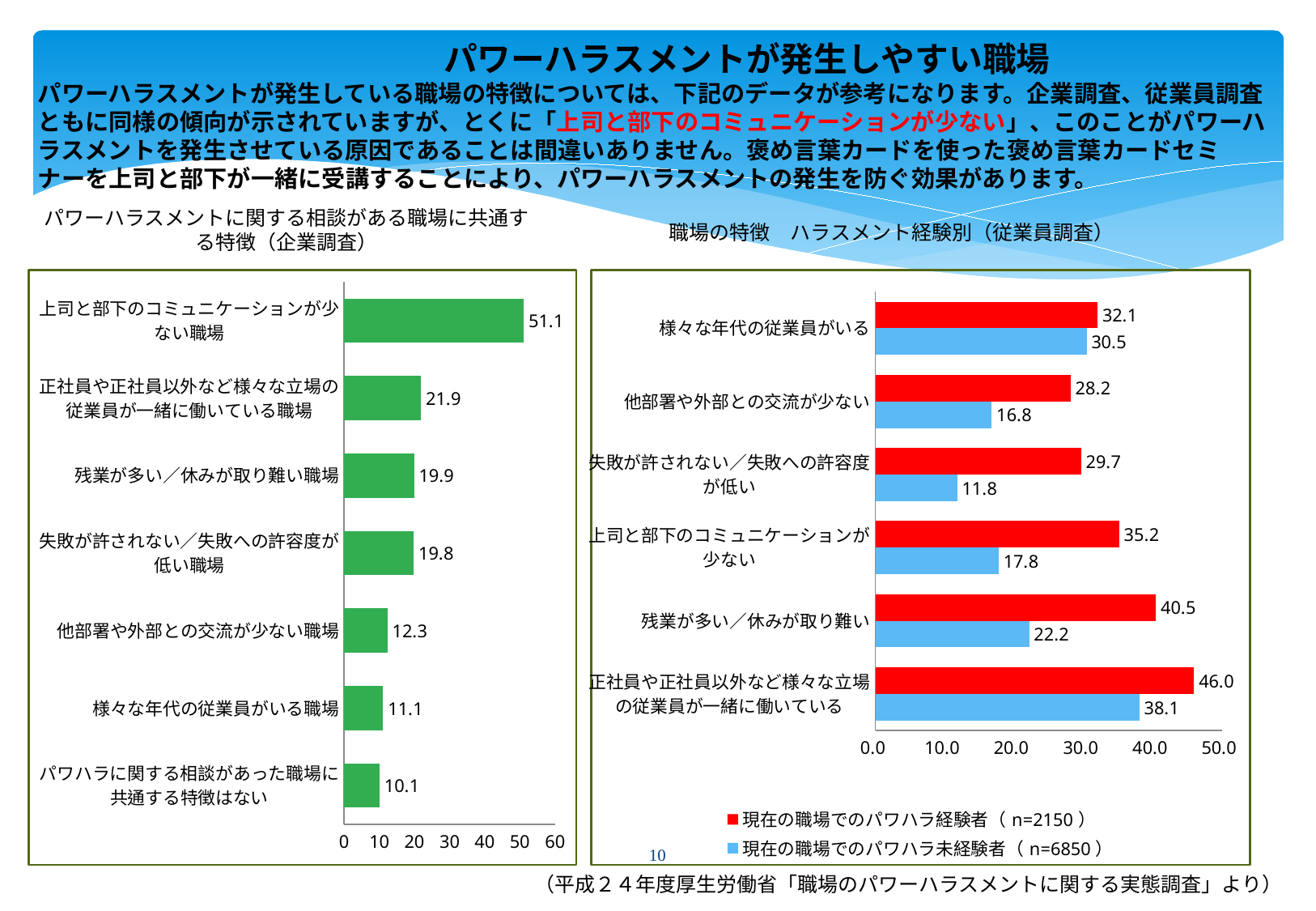
In the right chart (従業員調査), how many series does the legend list? 2 In the left chart (企業調査), which category has the lowest value? パワハラに関する相談があった職場に共通する特徴はない In the left chart (企業調査), how many categories are plotted? 7 In the left chart (企業調査), what is the value for 上司と部下のコミュニケーションが少ない職場? 51.1 In the right chart (従業員調査), what is the value for 現在の職場でのパワハラ経験者 for 残業が多い／休みが取り難い? 40.5 In the left chart (企業調査), what is the difference between 正社員や正社員以外など様々な立場の従業員が一緒に働いている職場 and 他部署や外部との交流が少ない職場? 9.6 In the right chart (従業員調査), which category has the highest value for 現在の職場でのパワハラ経験者? 正社員や正社員以外など様々な立場の従業員が一緒に働いている In the right chart (従業員調査), which is larger for 様々な年代の従業員がいる: 経験者 or 未経験者? 経験者 In the right chart (従業員調査), what is the difference between 経験者 and 未経験者 for 上司と部下のコミュニケーションが少ない? 17.4 In the left chart (企業調査), what kind of chart is shown? Bar chart In the right chart (従業員調査), what colour represents 現在の職場でのパワハラ経験者? Red In the right chart (従業員調査), what is the value for 現在の職場でのパワハラ未経験者 for 失敗が許されない／失敗への許容度が低い? 11.8